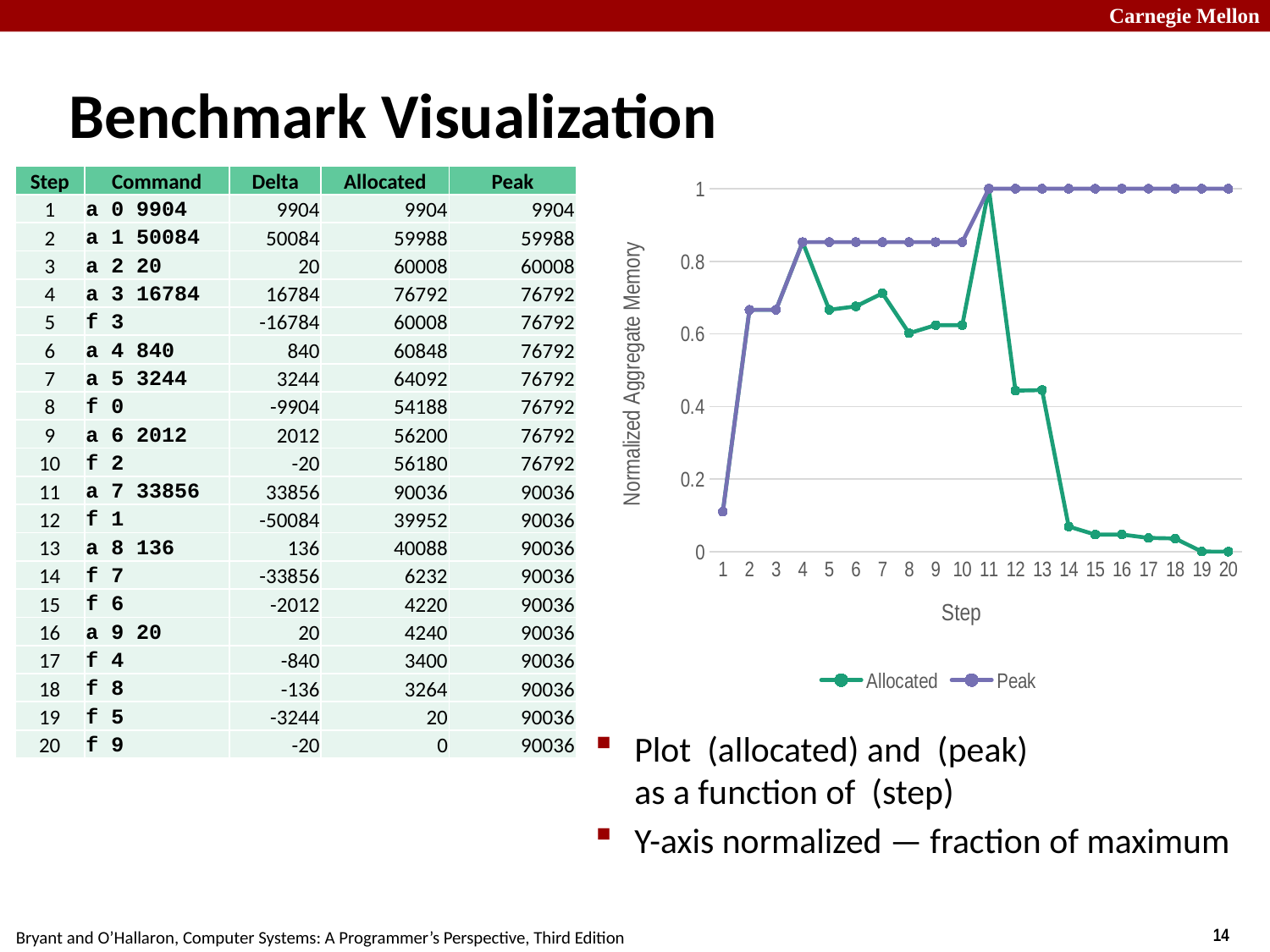
What kind of chart is shown on the slide? line chart What is the value of the Peak series at step 15? 1 At step 5, which series has the larger value, Allocated or Peak? Peak How many steps are plotted along the x axis of the chart? 20 What is the label of the chart's y axis? Normalized Aggregate Memory At which step does the Allocated series reach its highest value? 11 How many series does the chart legend list? 2 Is the value of the Allocated series at step 1 greater or less than 0.2? less At which step is the Peak series at its lowest value? 1 Is the value of the Peak series at step 4 greater or less than 0.8? greater What are the two series named in the chart legend? Allocated and Peak What is the value of the Allocated series at step 20? 0